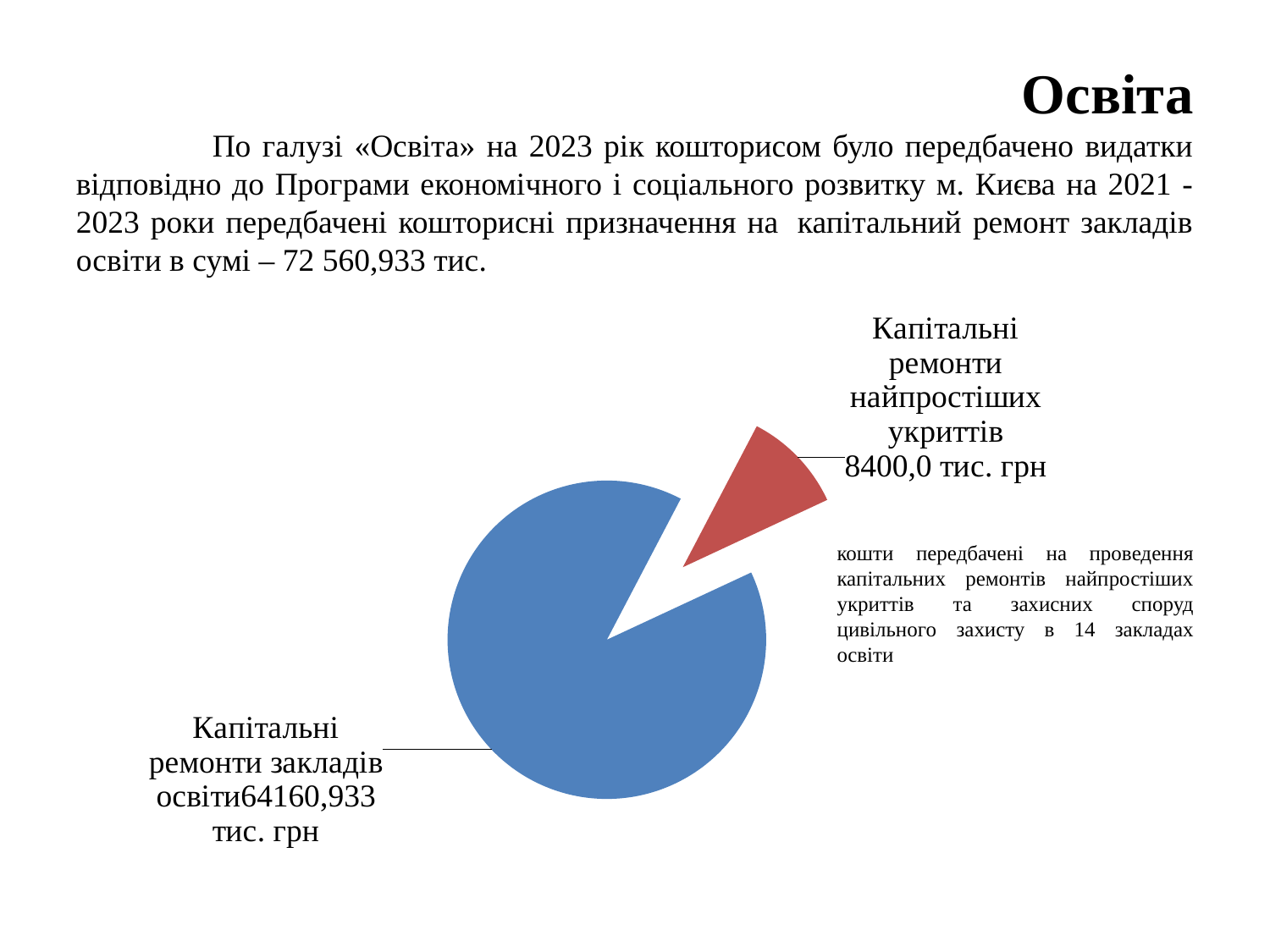
How many slices does the pie chart have? 2 What is the total of the two slices in the pie chart? 72 560,933 тис. грн Which slice of the pie chart is the largest? Капітальні ремонти закладів освіти Which is larger: the value for "Капітальні ремонти закладів освіти" or for "Капітальні ремонти найпростіших укриттів"? Капітальні ремонти закладів освіти What is the value for "Капітальні ремонти найпростіших укриттів"? 8400,0 тис. грн What is the difference between the value for "Капітальні ремонти закладів освіти" and the value for "Капітальні ремонти найпростіших укриттів"? 55760,933 тис. грн What colour is the slice for "Капітальні ремонти найпростіших укриттів"? red Which slice of the pie chart is the smallest? Капітальні ремонти найпростіших укриттів What kind of chart is shown on the slide? pie chart What colour is the slice for "Капітальні ремонти закладів освіти"? blue What is the value for "Капітальні ремонти закладів освіти"? 64160,933 тис. грн